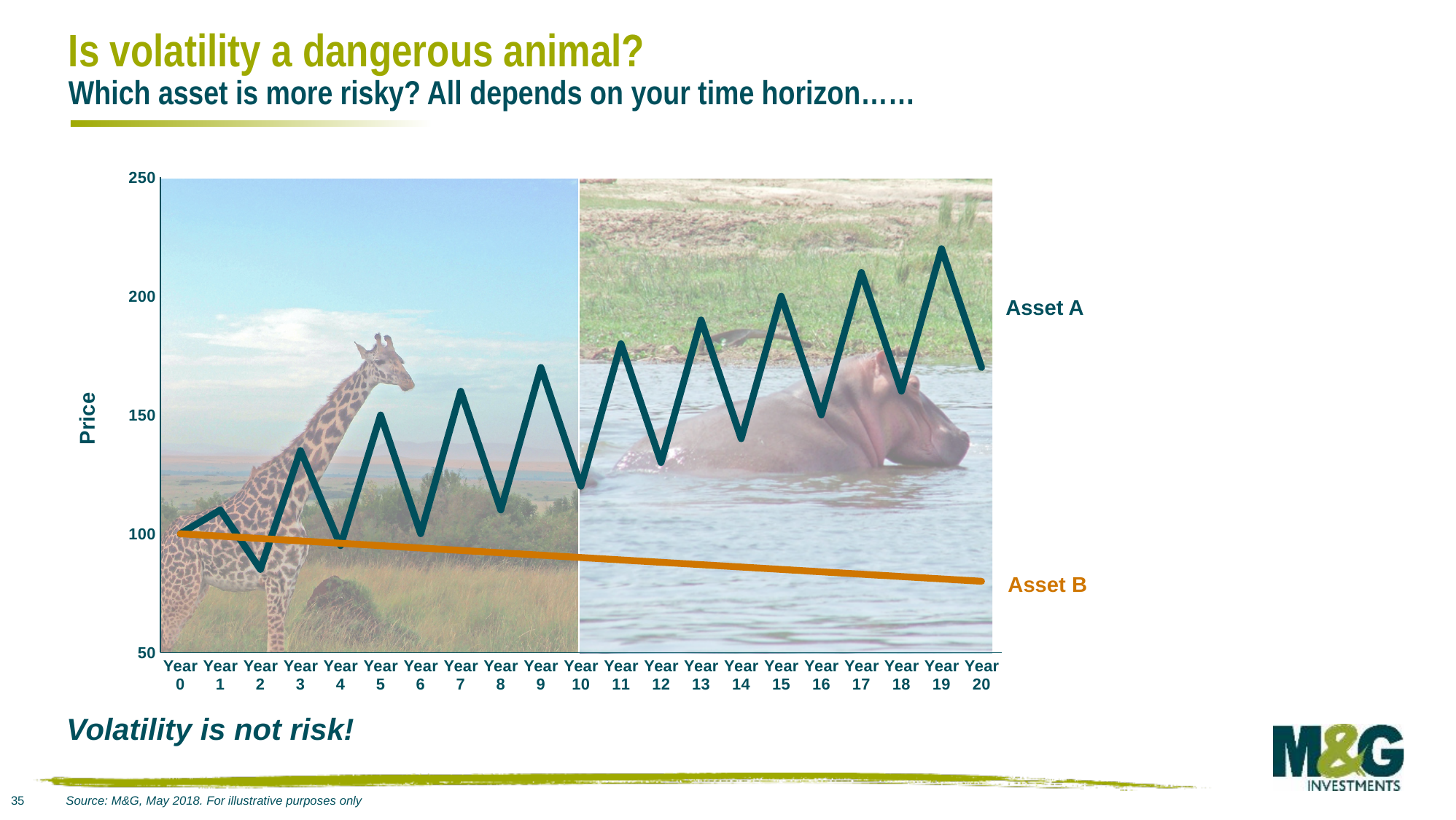
In which year does Asset A reach its lowest price? Year 2 At Year 20, which asset has the higher price, Asset A or Asset B? Asset A What kind of chart is shown on the slide? line chart In which year does Asset A reach its highest price? Year 19 Is the value for Asset B at Year 20 greater or less than 100? less Does the price of Asset B rise or fall from Year 0 to Year 20? fall What is the price of Asset A at Year 0? 100 What is the price of Asset B at Year 0? 100 How many year points are shown on the x axis? 21 Is the value for Asset A at Year 2 greater or less than 100? less How many series are plotted on the chart? 2 Is the value for Asset A at Year 19 greater or less than 200? greater